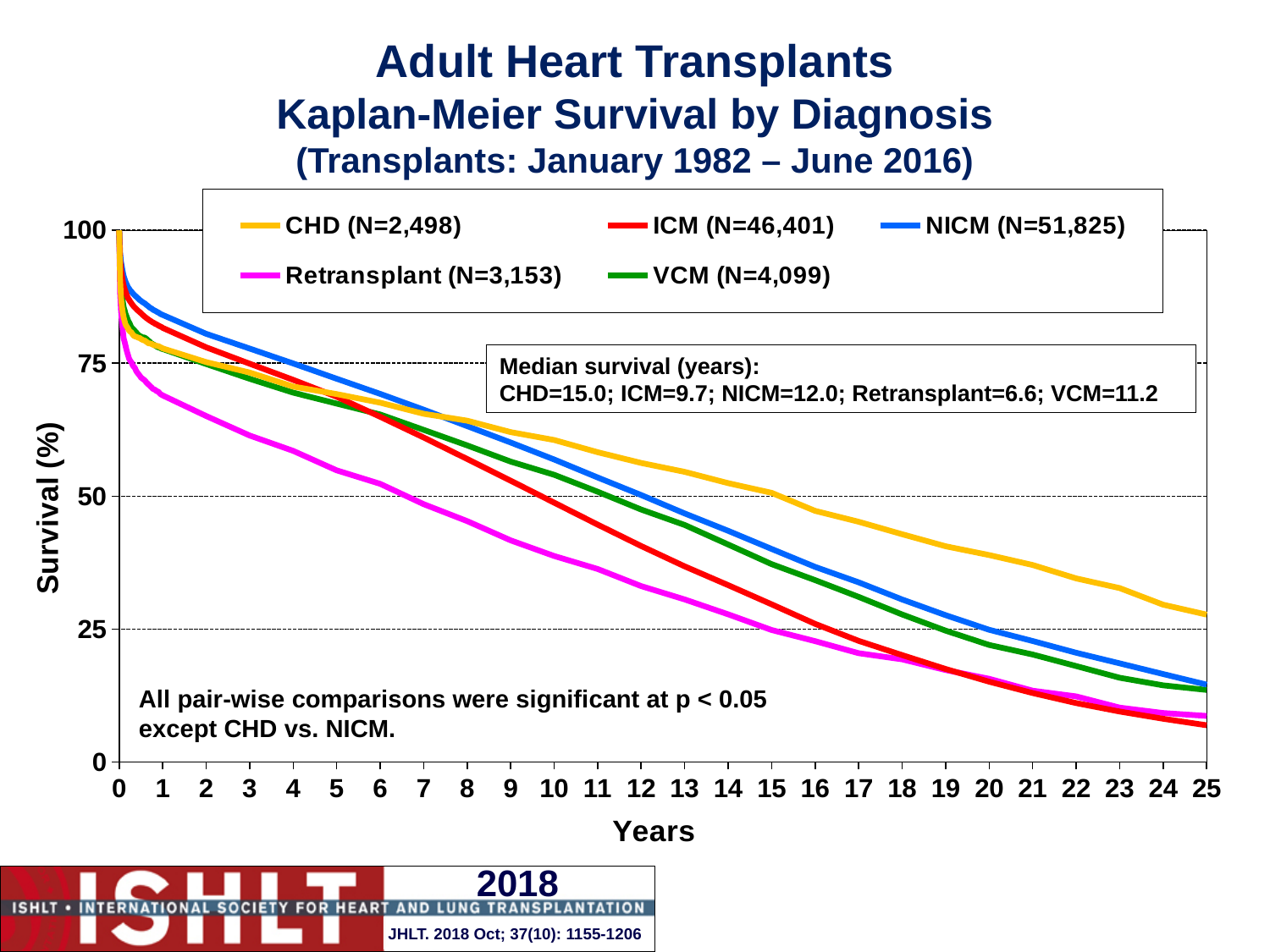
What is the difference in median survival (years) between CHD and ICM? 5.3 How many series does the legend list? 5 Which diagnosis has the highest median survival? CHD What is the median survival in years for Retransplant? 6.6 What is the median survival in years for CHD? 15.0 Do the survival curves rise or fall as years increase? fall Which has the larger median survival, NICM or VCM? NICM What kind of chart is shown on the slide? line chart Is the survival value for CHD at 25 years greater or less than 25%? greater Which diagnosis has the lowest median survival? Retransplant Is the survival value for Retransplant at 10 years greater or less than 50%? less What is the N shown in the legend for ICM? 46,401